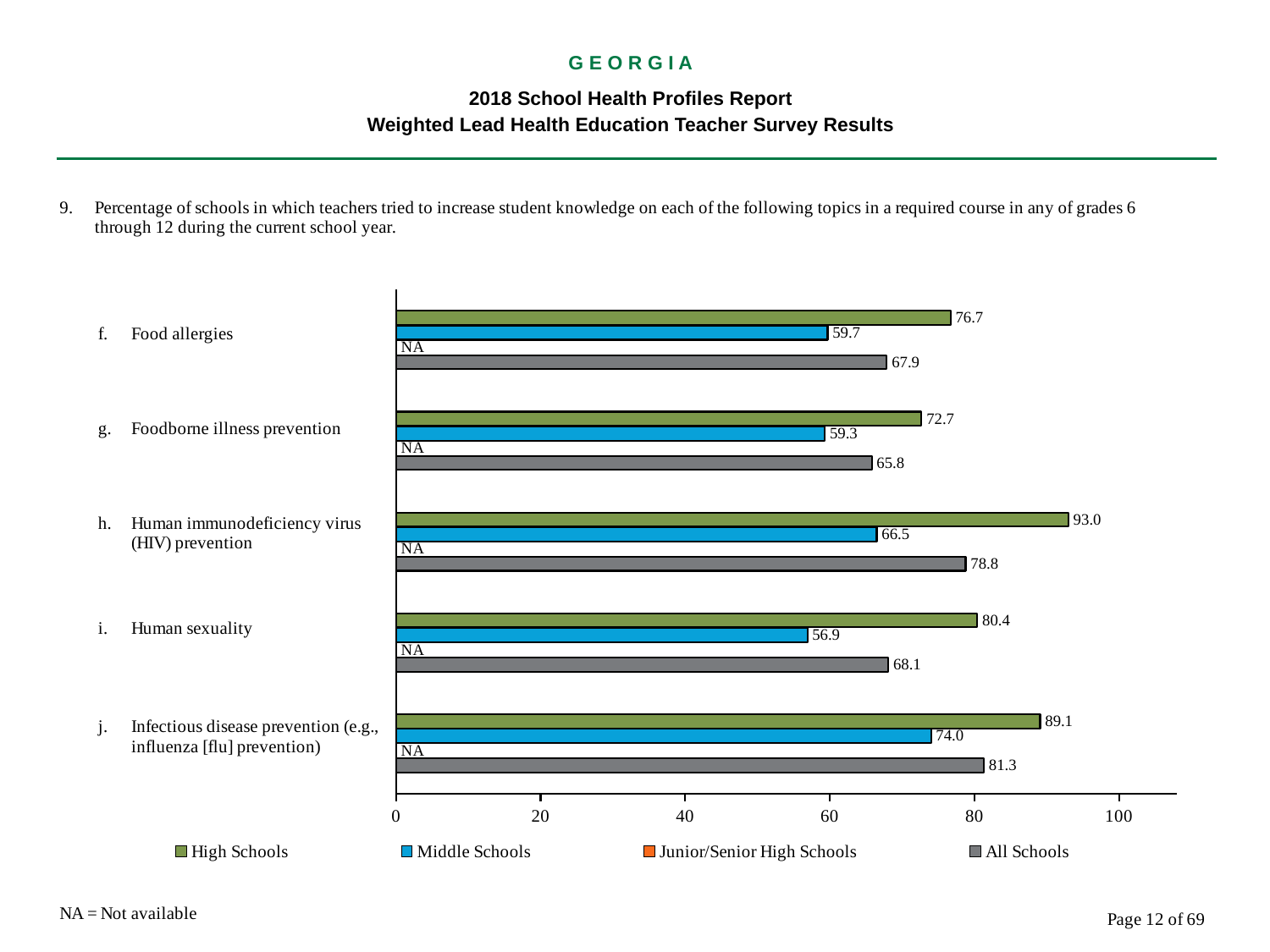
How many topics are shown on the chart? 5 What value is shown for Junior/Senior High Schools for each topic? NA Which topic has the lowest value for Middle Schools? Human sexuality What is the value for High Schools for Human immunodeficiency virus (HIV) prevention? 93.0 Which topic has the highest value for High Schools? Human immunodeficiency virus (HIV) prevention What is the difference between the High Schools and Middle Schools values for Human sexuality? 23.5 Is the Middle Schools value for Infectious disease prevention greater or less than 60? greater What is the value for All Schools for Infectious disease prevention (e.g., influenza [flu] prevention)? 81.3 How many series does the legend list? 4 What is the value for Middle Schools for Food allergies? 59.7 What kind of chart is shown on the slide? bar chart Which is larger: the All Schools value for Food allergies or the All Schools value for Foodborne illness prevention? Food allergies